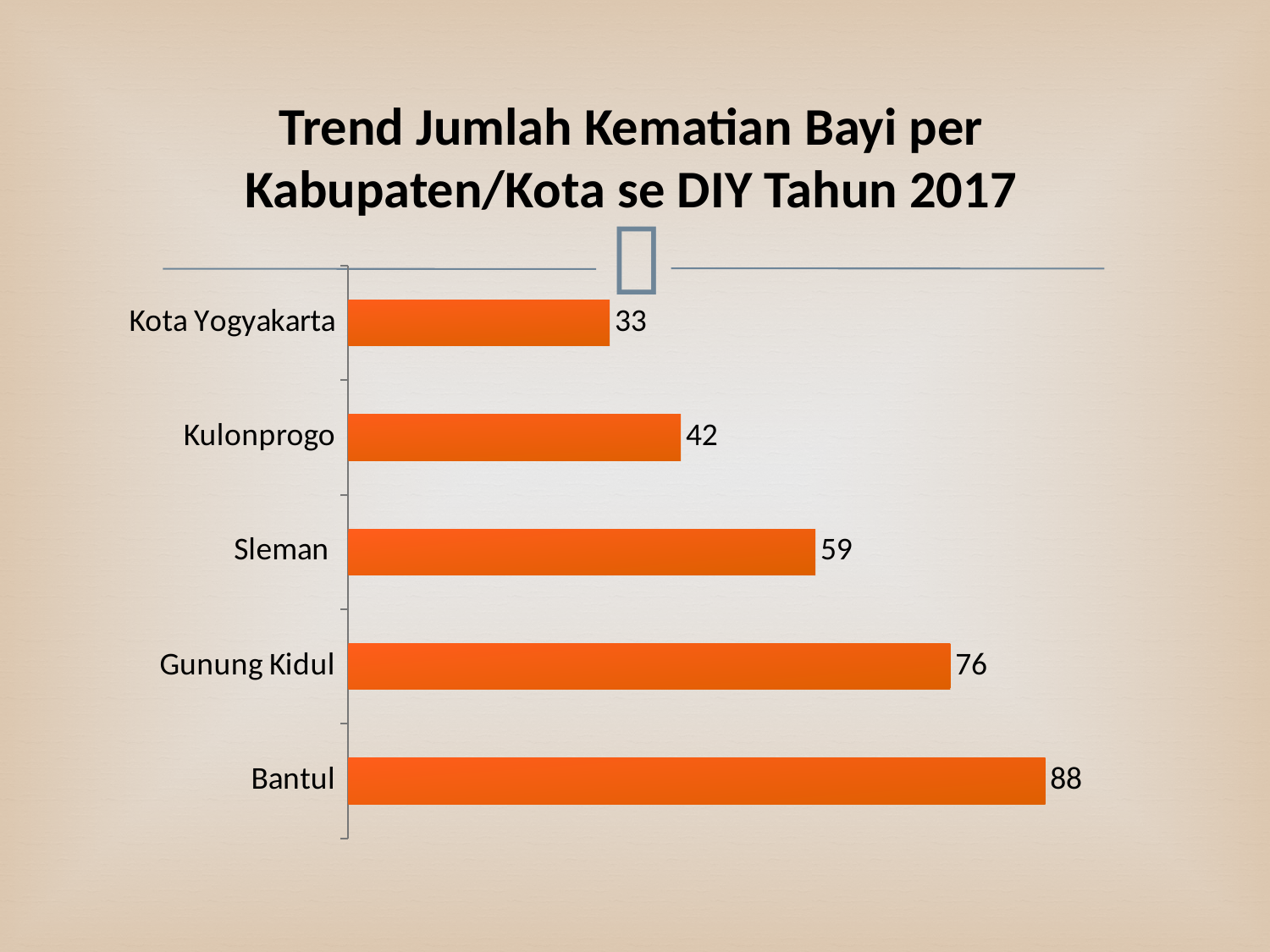
What is the difference between the values for Sleman and Kulonprogo? 17 Which category has the lowest value? Kota Yogyakarta Which is larger, the value for Gunung Kidul or the value for Sleman? Gunung Kidul What is the title of the chart? Trend Jumlah Kematian Bayi per Kabupaten/Kota se DIY Tahun 2017 What is the value for Kulonprogo? 42 How many categories are shown in the chart? 5 What is the difference between the values for Bantul and Gunung Kidul? 12 Which category has the highest value? Bantul What kind of chart is shown on the slide? bar chart What is the value for Sleman? 59 What is the value for Bantul? 88 What is the value for Kota Yogyakarta? 33